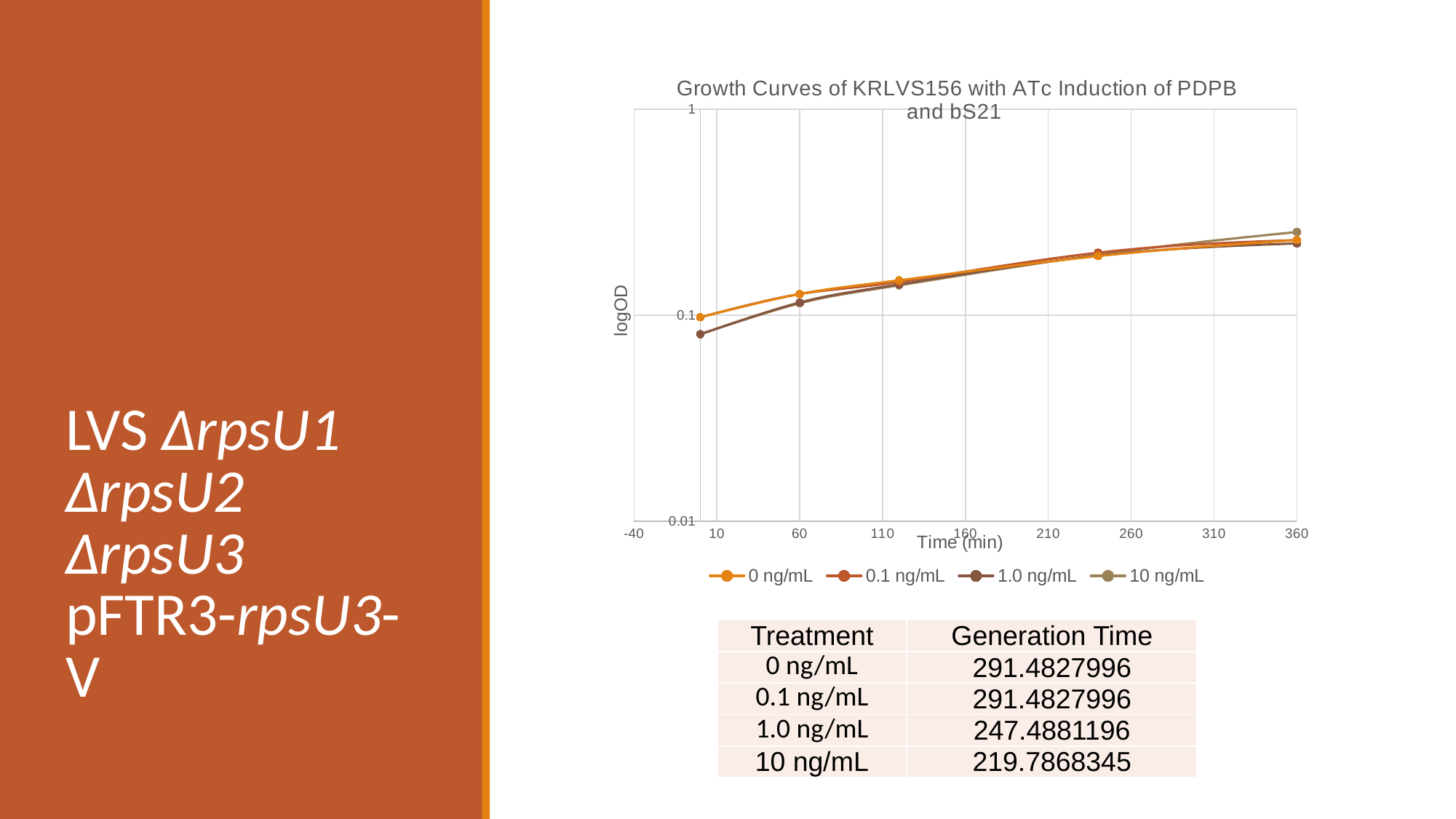
At the first time point, which is larger: the value for 0 ng/mL or the value for 1.0 ng/mL? 0 ng/mL Do the logOD values rise or fall as time increases along the x axis? rise What is the label of the y axis of the chart? logOD How many series does the legend of the growth curve chart list? 4 What kind of chart is shown on the slide? line chart Is the value for 1.0 ng/mL at the first time point greater or less than 0.1? less Is the value for 10 ng/mL at 360 min greater or less than 0.1? greater Which series has the highest logOD at 360 min? 10 ng/mL Is the value for 0 ng/mL at 360 min greater or less than 1? less How many data points are plotted for each series in the chart? 5 What is the title of the chart? Growth Curves of KRLVS156 with ATc Induction of PDPB and bS21